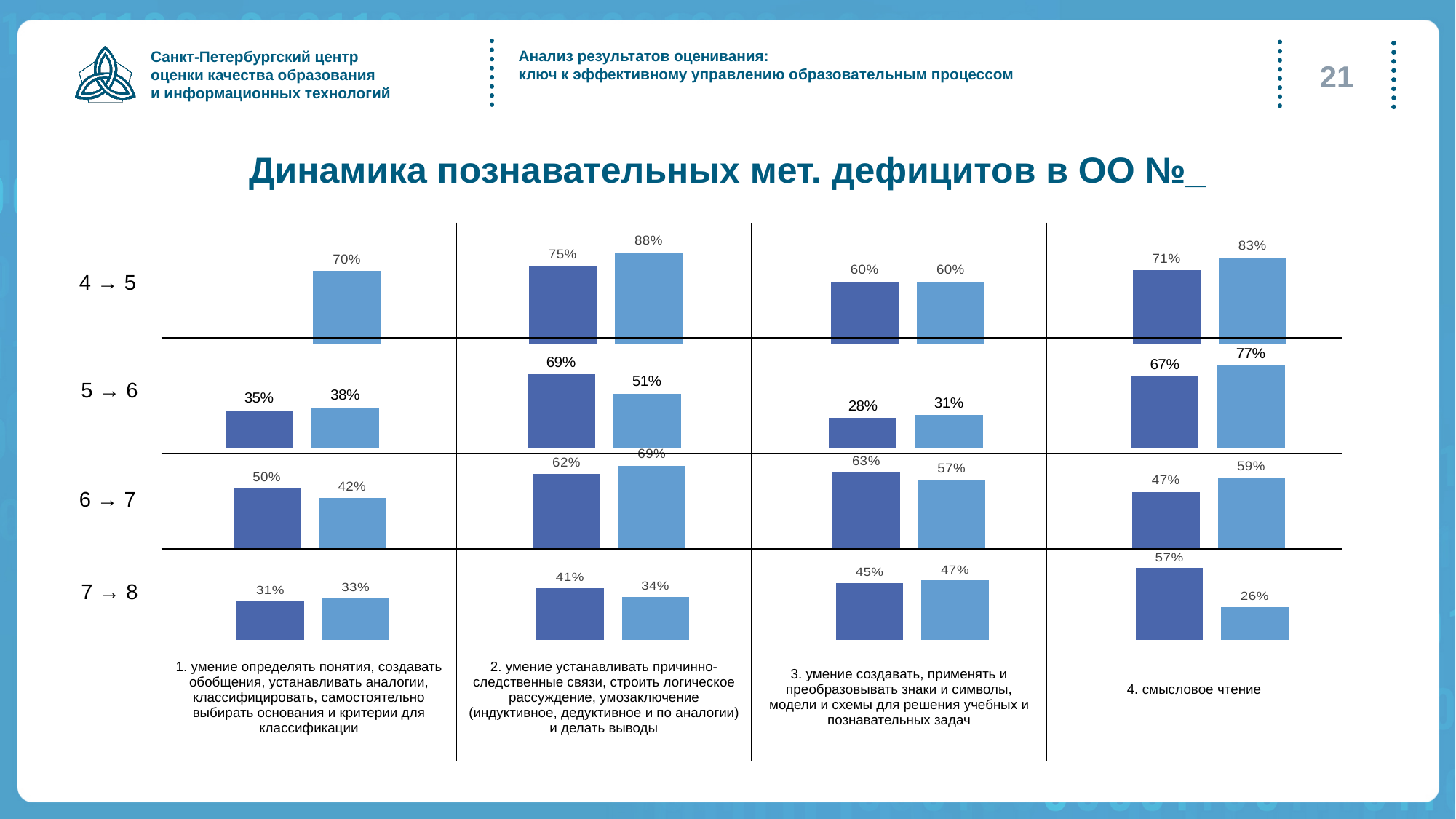
In the chart for row "7 → 8" and skill 4 (смысловое чтение), which bar is larger, the dark blue or the light blue? dark blue In the chart for row "7 → 8" and skill 4 (смысловое чтение), what value is shown on the dark blue bar? 57% In the chart for row "5 → 6" and skill 3 (умение создавать, применять и преобразовывать знаки и символы), what value is shown on the light blue bar? 31% In the chart for row "5 → 6" and skill 2 (умение устанавливать причинно-следственные связи), which bar is larger, the dark blue or the light blue? dark blue Across the row "7 → 8", which skill chart has the lowest labelled value? Skill 4 (26%) In the chart for row "6 → 7" and skill 1 (умение определять понятия), what is the difference between the dark blue bar and the light blue bar? 8% Across the row "4 → 5", which skill chart has the highest labelled value? Skill 2 (88%) What kind of chart is used in each cell of the grid on this slide? Bar chart In the chart for row "4 → 5" and skill 3 (умение создавать, применять и преобразовывать знаки и символы), what value is shown on both bars? 60% In the chart for row "5 → 6" and skill 4 (смысловое чтение), what is the difference between the light blue bar and the dark blue bar? 10% In the chart for row "4 → 5" and skill 2 (умение устанавливать причинно-следственные связи), what value is shown on the light blue bar? 88% How many grade-transition rows (e.g. 4 → 5) are shown on the slide? 4